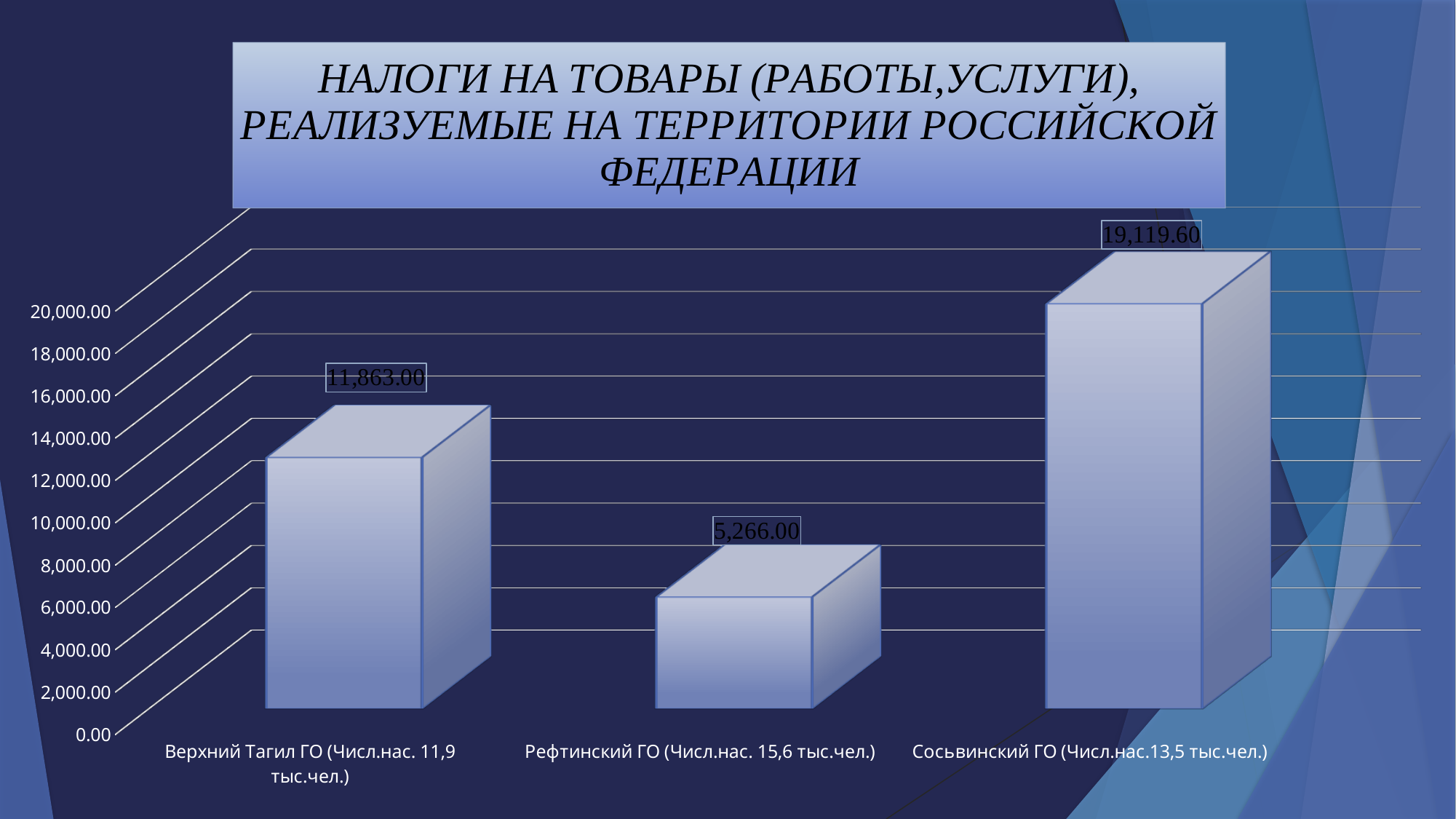
What is the difference between the values for Сосьвинский ГО and Верхний Тагил ГО? 7,256.60 Which is larger, the value for Верхний Тагил ГО or the value for Рефтинский ГО? Верхний Тагил ГО Which category has the lowest value? Рефтинский ГО Which category has the highest value? Сосьвинский ГО What is the value for Сосьвинский ГО? 19,119.60 What is the value for Верхний Тагил ГО? 11,863.00 What is the difference between the values for Верхний Тагил ГО and Рефтинский ГО? 6,597.00 What is the title of the chart? НАЛОГИ НА ТОВАРЫ (РАБОТЫ,УСЛУГИ), РЕАЛИЗУЕМЫЕ НА ТЕРРИТОРИИ РОССИЙСКОЙ ФЕДЕРАЦИИ What is the value for Рефтинский ГО? 5,266.00 Is the value for Рефтинский ГО greater or less than 6,000.00? less What kind of chart is shown on the slide? bar chart How many categories are shown in the chart? 3